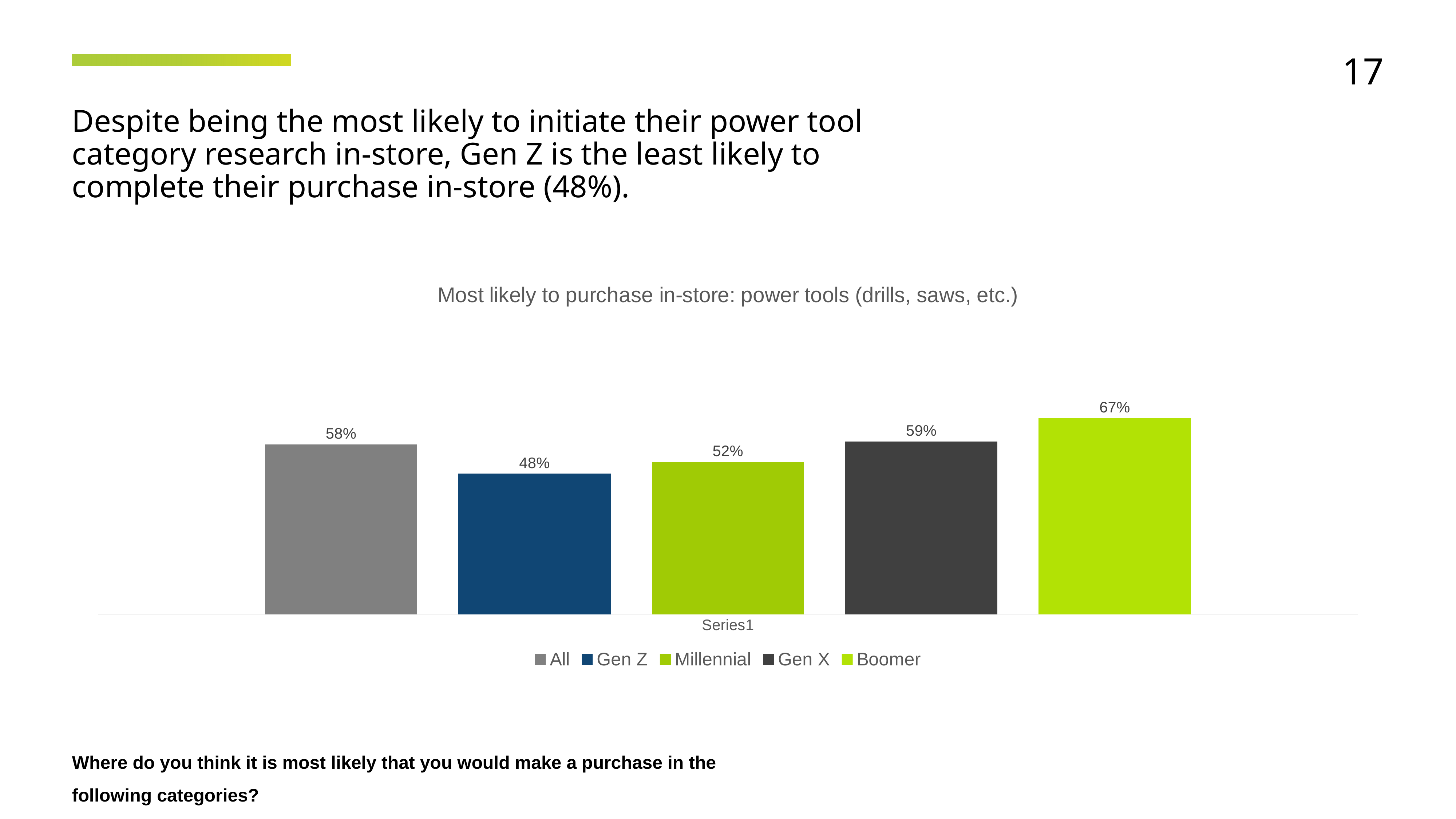
How many series does the legend list? 5 What is the difference between the Boomer value and the Gen Z value? 19% What kind of chart is shown? Bar chart Which group has the highest value? Boomer Which group has the lowest value? Gen Z What is the difference between the Gen X value and the Millennial value? 7% What is the value for Gen Z? 48% What is the title of the chart? Most likely to purchase in-store: power tools (drills, saws, etc.) What is the value for Millennial? 52% Which is larger, the value for Gen X or the value for Millennial? Gen X What is the value for All? 58% What is the value for Boomer? 67%